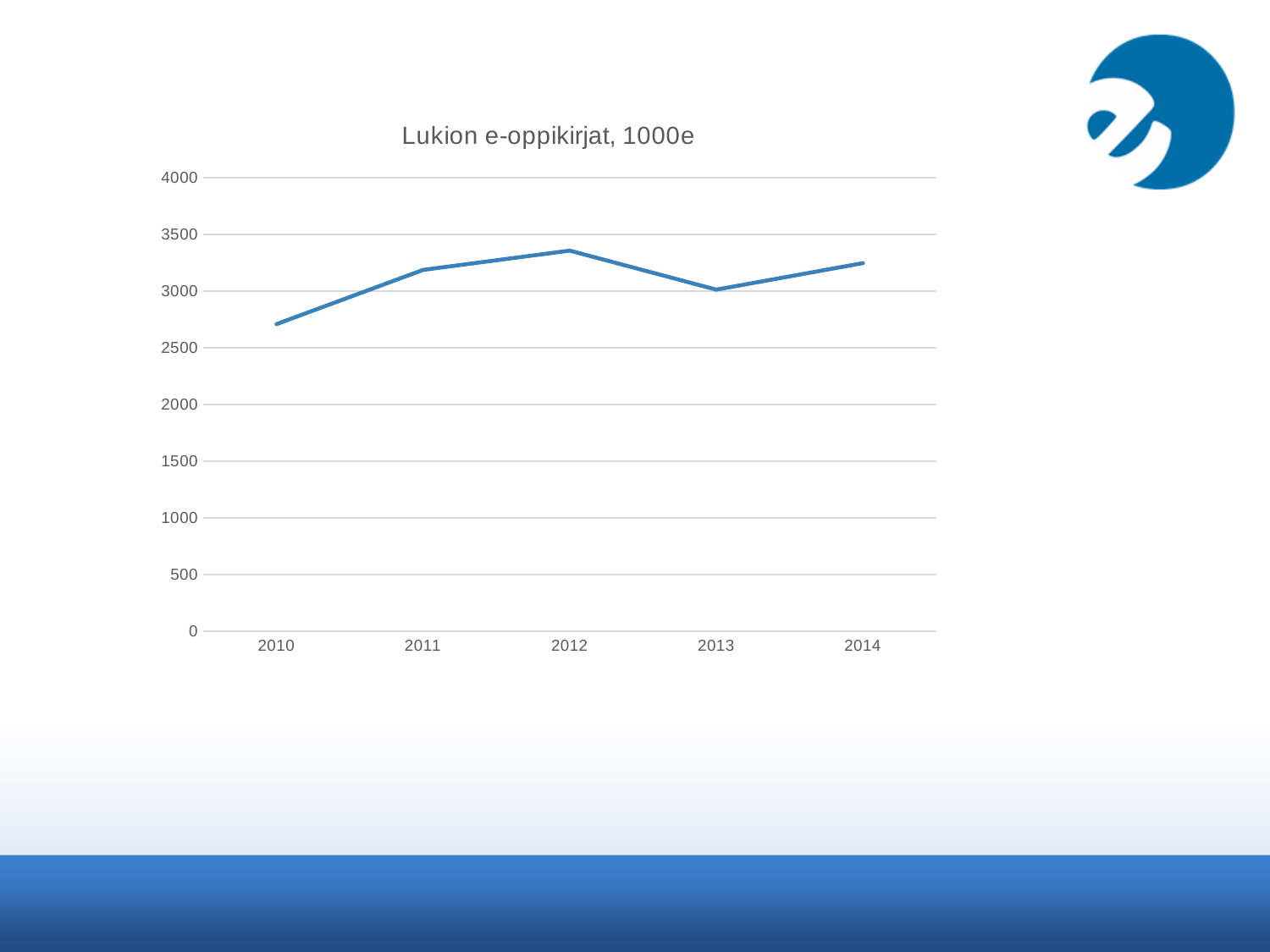
Which is larger, the value for 2010 or the value for 2011? 2011 Is the value for 2012 greater or less than 3000? greater What kind of chart is shown on the slide? line chart Which is larger, the value for 2012 or the value for 2013? 2012 Is the value for 2010 greater or less than 3000? less Which year has the highest value? 2012 Is the value for 2013 greater or less than 3500? less Does the line rise or fall from 2010 to 2012? rise What is the title of the chart? Lukion e-oppikirjat, 1000e How many years are plotted on the x axis? 5 Which year has the lowest value? 2010